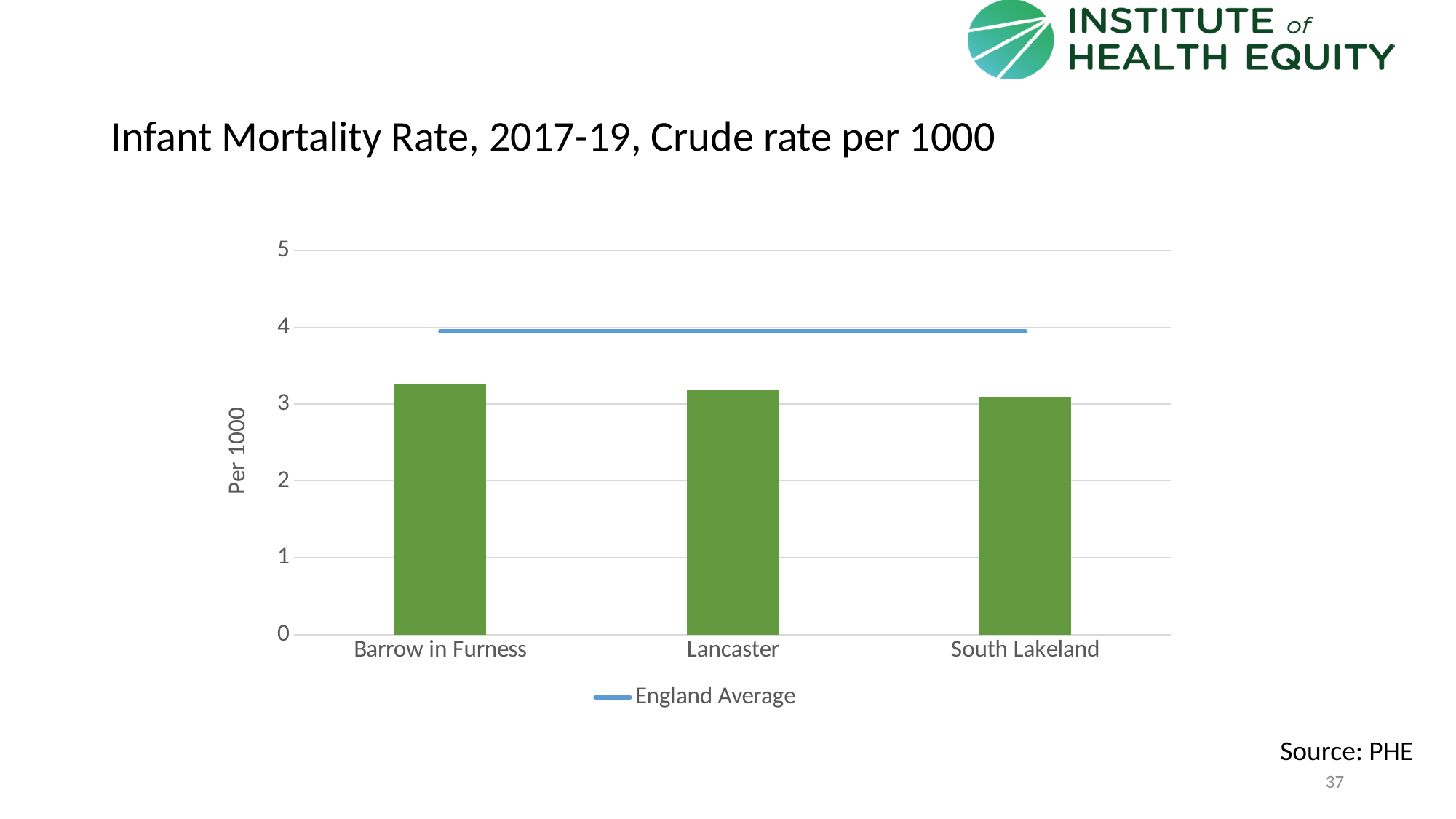
Which area has the lowest infant mortality rate bar? South Lakeland How many local areas are shown on the x axis of the chart? 3 Is the value for Barrow in Furness greater or less than 4? less How many entries does the chart's legend list? 1 What kind of chart is shown on the slide? combination bar and line chart Do the bar values rise or fall moving from left to right across the x axis? fall Is the value for Lancaster greater or less than 3? greater Which area has the highest infant mortality rate bar? Barrow in Furness Which has the higher infant mortality rate, Barrow in Furness or South Lakeland? Barrow in Furness What is the title of the chart? Infant Mortality Rate, 2017-19, Crude rate per 1000 What is the label on the vertical axis of the chart? Per 1000